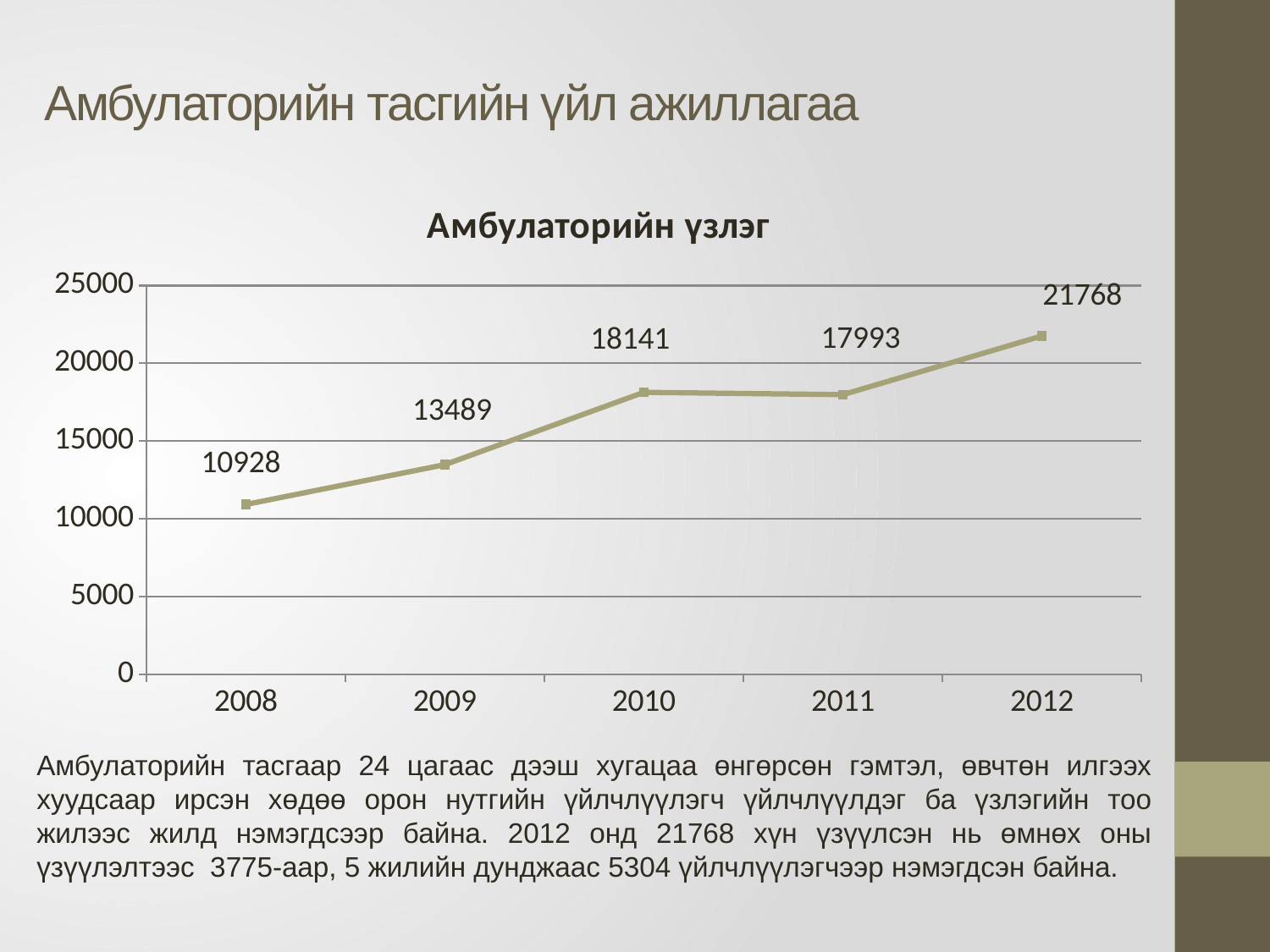
Which is larger, the value for 2010 or the value for 2011? 2010 What is the value for 2008? 10928 What kind of chart is shown on the slide? line chart What is the value for 2010? 18141 Which year has the lowest value? 2008 How many years are plotted on the chart? 5 What is the title of the chart? Амбулаторийн үзлэг Which year has the highest value? 2012 What is the difference between the values for 2009 and 2008? 2561 What is the value for 2012? 21768 What is the difference between the values for 2012 and 2011? 3775 Is the value for 2009 greater or less than 15000? less